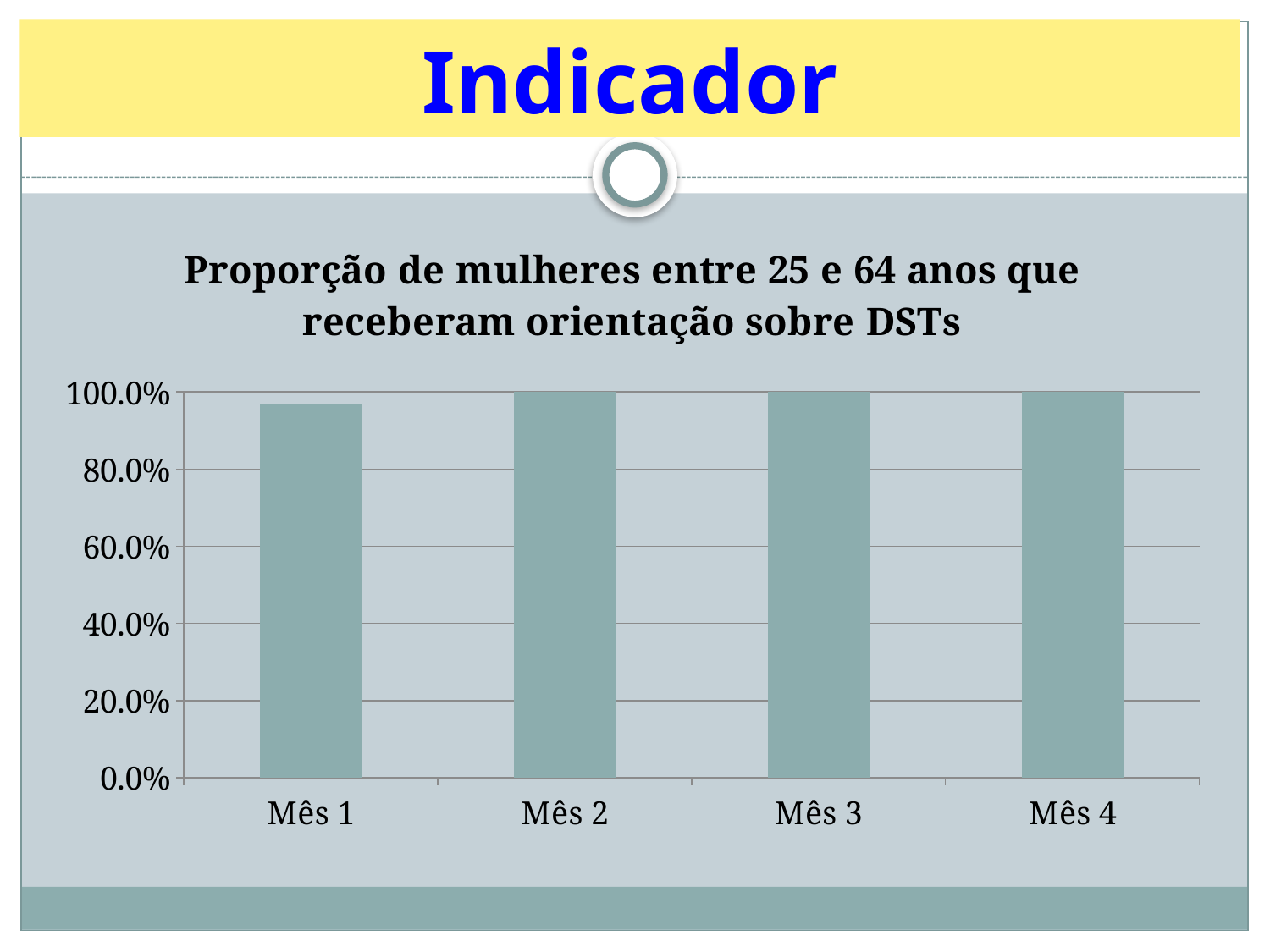
What is the value for Mês 4? 100.0% Which is larger, the value for Mês 1 or the value for Mês 2? Mês 2 Do the values rise or fall from Mês 1 to Mês 2? rise What is the highest value shown on the y axis of the chart? 100.0% Which month has the lowest value? Mês 1 Is the value for Mês 1 greater or less than 80.0%? greater What is the title of the chart? Proporção de mulheres entre 25 e 64 anos que receberam orientação sobre DSTs What kind of chart is shown on the slide? bar chart How many categories (months) are shown on the x axis of the chart? 4